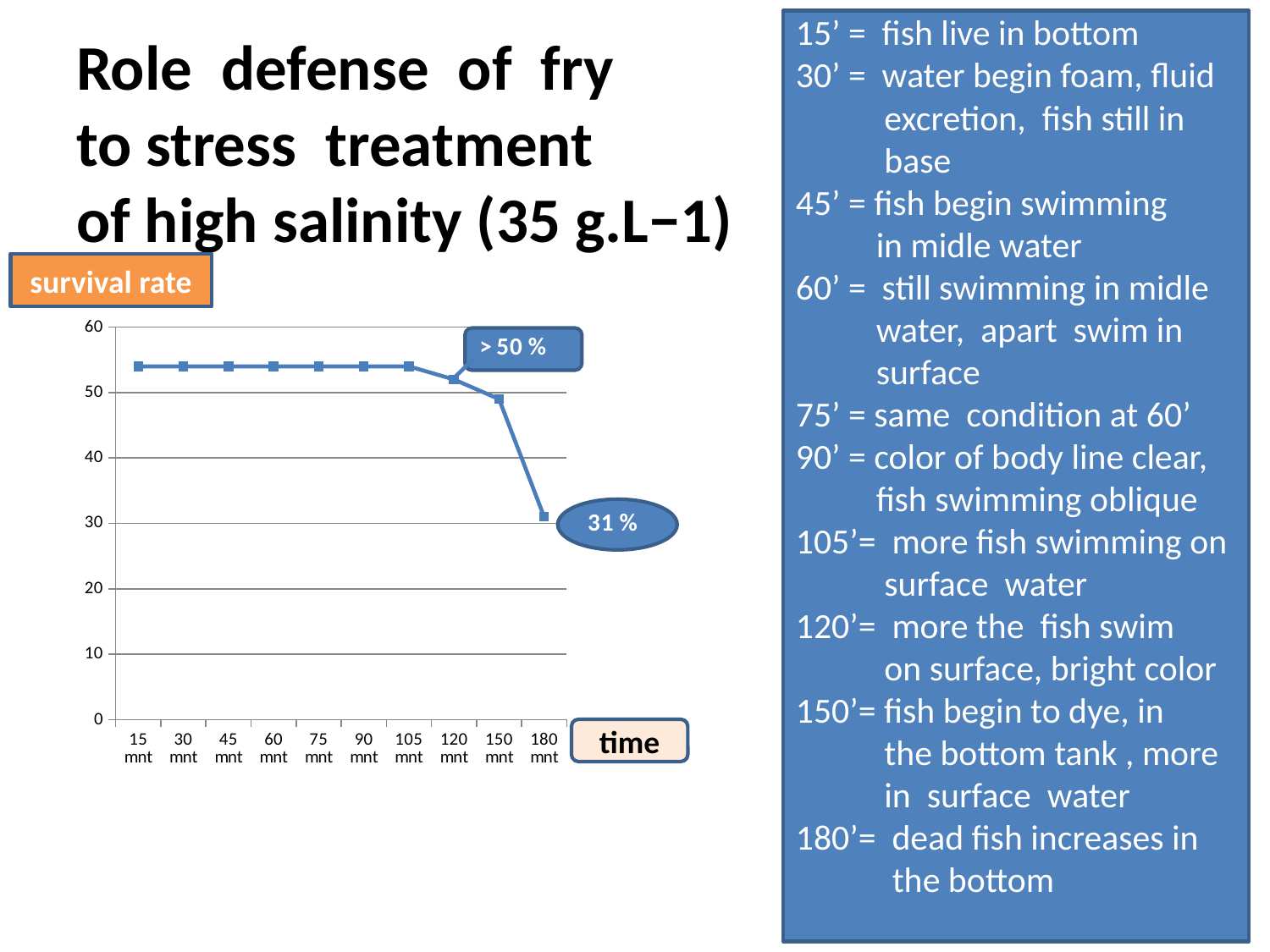
What label is shown for the vertical axis of the chart? survival rate Is the survival rate at 180 mnt greater or less than 40? less Is the survival rate at 15 mnt greater or less than 50? greater Do the survival rate values rise or fall along the x axis from 105 mnt to 180 mnt? fall Which has the higher survival rate, 105 mnt or 180 mnt? 105 mnt Is the survival rate at 150 mnt greater or less than 40? greater What label is shown for the horizontal axis of the chart? time At which time point is the survival rate lowest? 180 mnt What survival rate does the callout label give for the point at 180 mnt? 31 % What kind of chart is shown on the slide? line chart How many time points are plotted on the x axis of the chart? 10